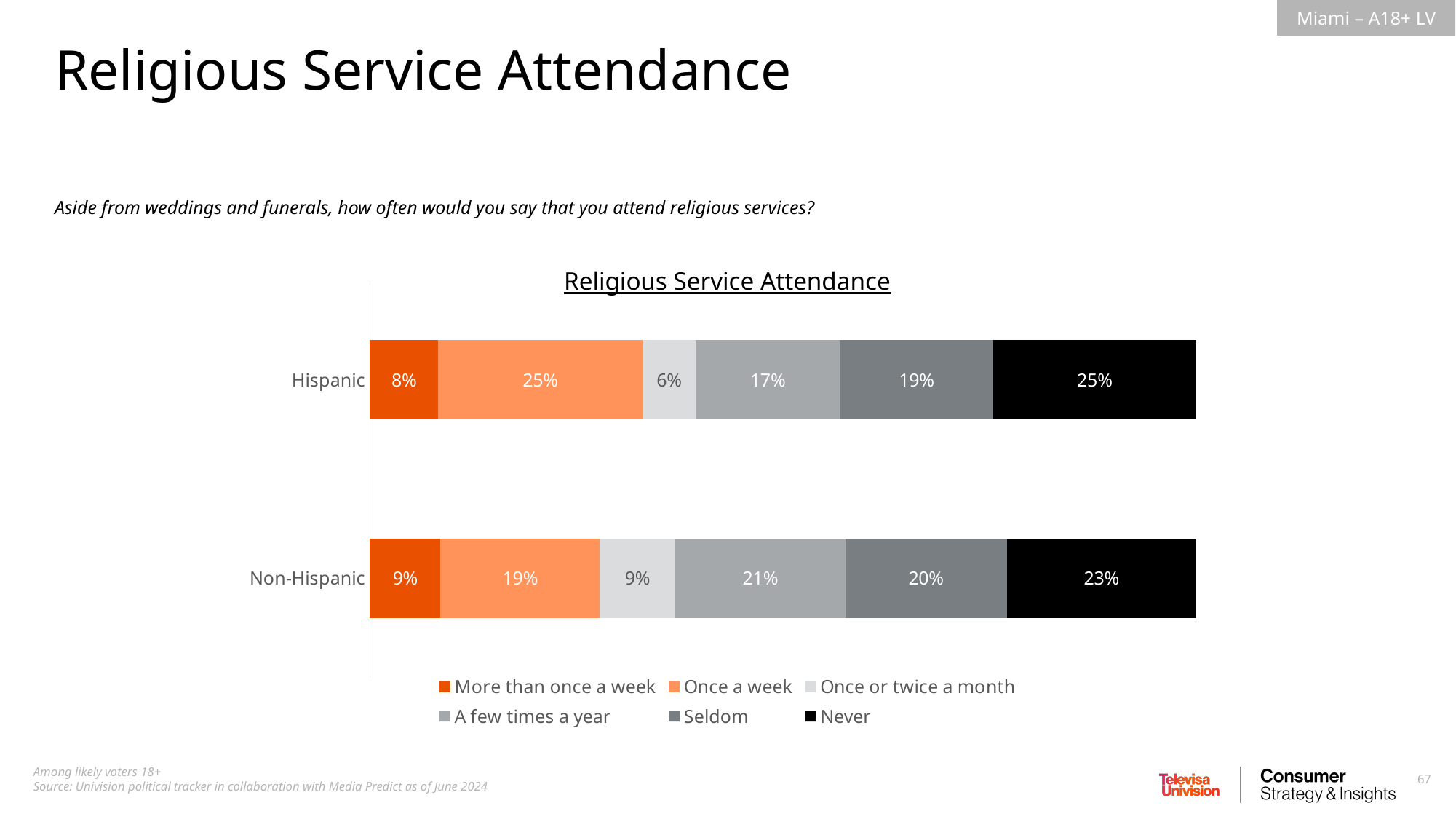
How many groups (bars) are shown in the chart? 2 What is the title of the chart? Religious Service Attendance What is the value for 'Once or twice a month' among Non-Hispanic respondents? 9% How many series does the legend list? 6 What percentage of Hispanic respondents say they attend religious services once a week? 25% What kind of chart is shown on the slide? Stacked bar chart What is the difference between the Hispanic and Non-Hispanic values for 'Once a week'? 6% Which category has the highest value for Non-Hispanic respondents? Never Which group has a larger value for 'A few times a year', Hispanic or Non-Hispanic? Non-Hispanic What is the value for 'Seldom' among Hispanic respondents? 19% What percentage of Non-Hispanic respondents say they never attend religious services? 23% Which category has the lowest value for Hispanic respondents? Once or twice a month